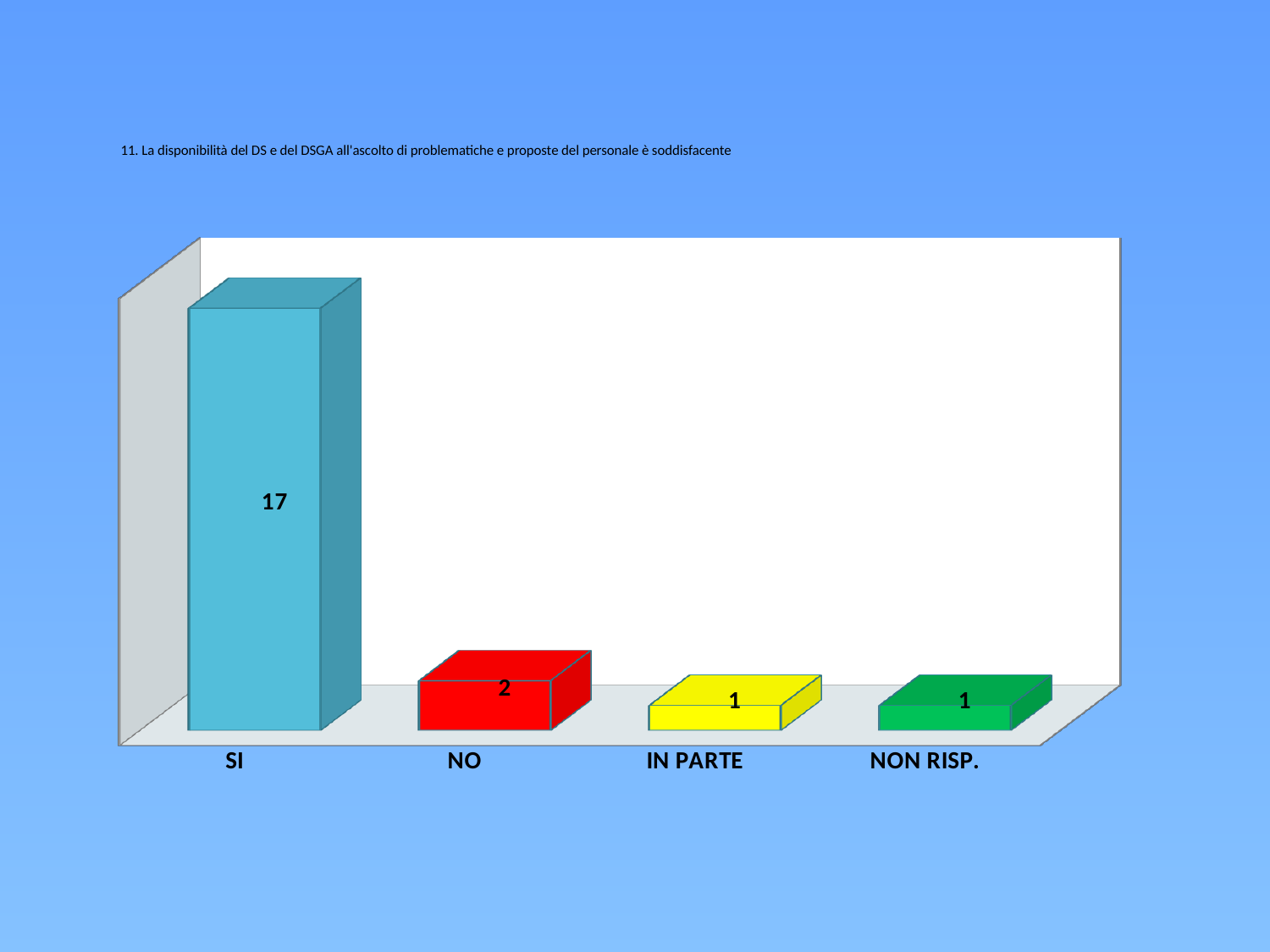
Which category has the highest value? SI What is the value for NON RISP.? 1 What is the total of all the values shown in the chart? 21 What kind of chart is shown on the slide? Bar chart What is the difference between the values for SI and NO? 15 What is the difference between the values for NO and NON RISP.? 1 How many categories are shown on the x axis? 4 What is the value for NO? 2 What is the value for IN PARTE? 1 What colour is the bar for NO? Red What is the value for SI? 17 Which is larger, the value for NO or the value for IN PARTE? NO